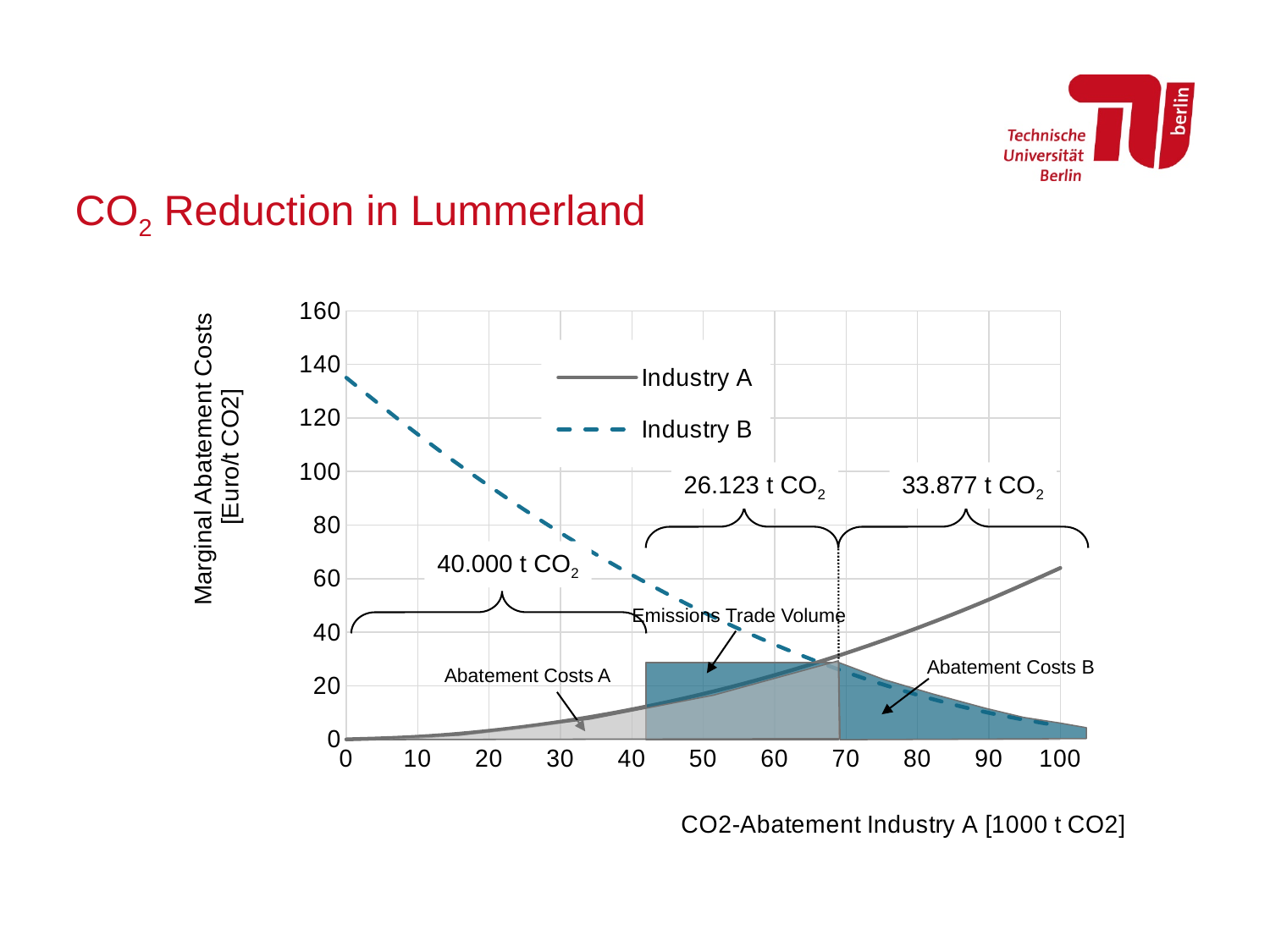
What is the title of the x axis? CO2-Abatement Industry A [1000 t CO2] At x = 90, which series has the higher value, Industry A or Industry B? Industry A What kind of chart is shown on the slide? line chart Do the values for Industry A rise or fall as the x axis increases? rise Is the value for Industry B at x = 0 greater or less than 120? greater Is the value for Industry A at x = 100 greater or less than 40? greater Is the value for Industry B at x = 100 greater or less than 20? less Which series is drawn with a dashed line? Industry B How many series does the legend list? 2 Do the values for Industry B rise or fall as the x axis increases? fall At x = 20, which series has the higher value, Industry A or Industry B? Industry B